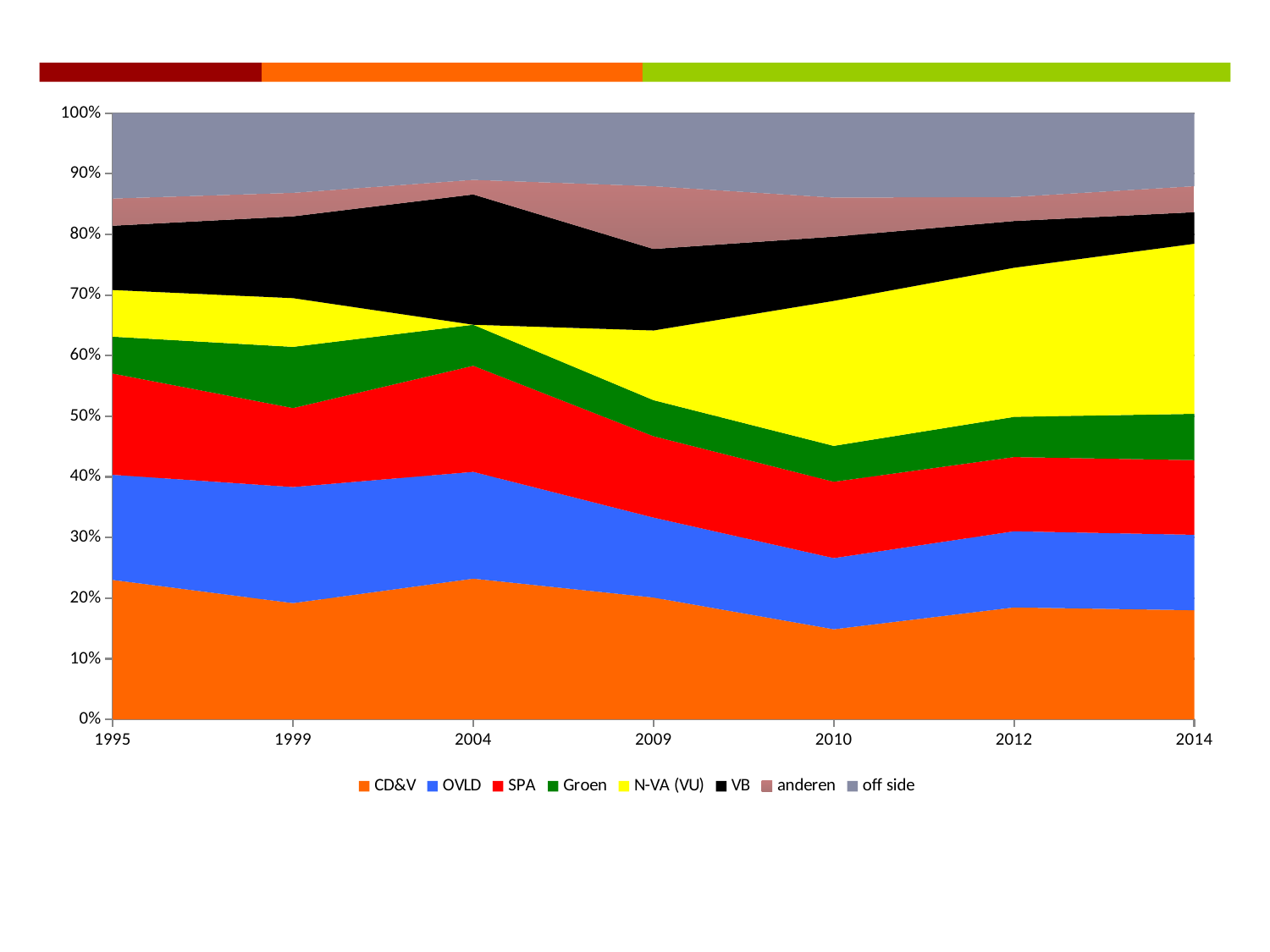
Is the value for CD&V in 2004 greater or less than 20%? greater Does the CD&V value rise or fall from 2004 to 2010? fall How many series does the legend list? 8 Which series is listed last in the legend? off side Which is larger, the CD&V value in 1995 or in 2010? 1995 What is the first year shown on the x axis? 1995 What kind of chart is shown on the slide? area chart In which year is the CD&V value lowest? 2010 How many years are plotted along the x axis? 7 Is the value for CD&V in 1995 greater or less than 20%? greater Is the value for CD&V in 2010 greater or less than 20%? less Which series is listed first in the legend? CD&V